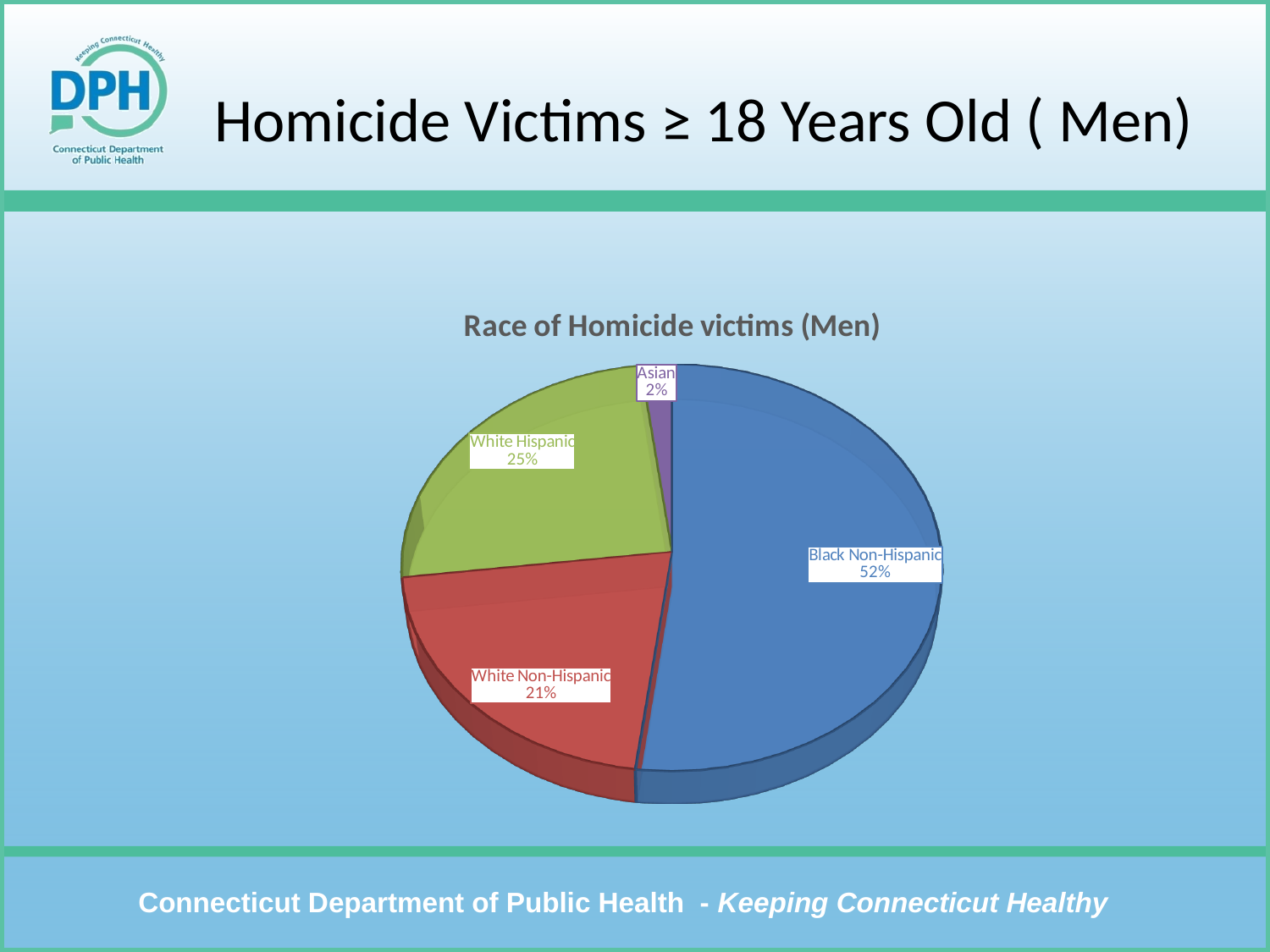
What is the difference in percentage points between the Black Non-Hispanic and White Hispanic shares? 27 Which is larger, the White Hispanic share or the White Non-Hispanic share? White Hispanic How many slices does the pie chart have? 4 Which race category has the largest share of the pie? Black Non-Hispanic What share of the pie is White Non-Hispanic? 21% What share of the pie is Asian? 2% What share of the pie is White Hispanic? 25% What is the title of the chart? Race of Homicide victims (Men) Which race category has the smallest share of the pie? Asian What type of chart is shown on the slide? pie chart What colour is the Black Non-Hispanic slice? blue